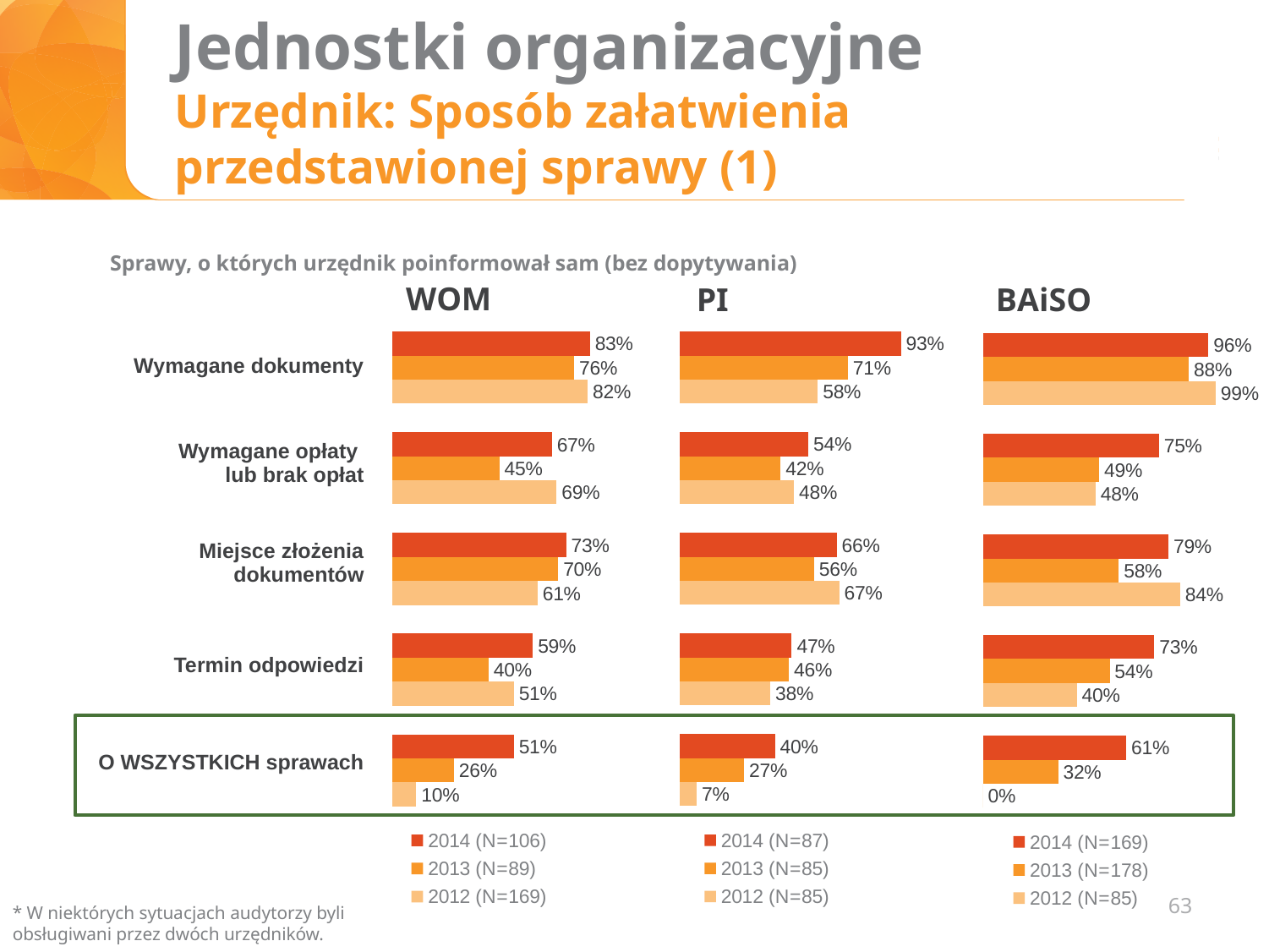
How many categories are shown in the PI chart? 5 In the PI chart, what is the 2012 value for O WSZYSTKICH sprawach? 7% In the WOM chart, which is larger for Miejsce złożenia dokumentów: the 2014 value or the 2012 value? 2014 In the BAiSO chart, which category has the highest 2012 value? Wymagane dokumenty In the BAiSO chart, what is the 2013 value for Termin odpowiedzi? 54% In the WOM chart, which category has the lowest 2013 value? O WSZYSTKICH sprawach In the BAiSO chart, what is the 2012 value for O WSZYSTKICH sprawach? 0% In the PI chart, what is the difference between the 2014 and 2013 values for Wymagane dokumenty? 22 percentage points In the WOM chart, what is the 2014 value for Wymagane dokumenty? 83% What sample size (N) is given for 2014 in the legend of the PI chart? N=87 What type of chart is the WOM chart? Bar chart How many series does the legend of the BAiSO chart list? 3